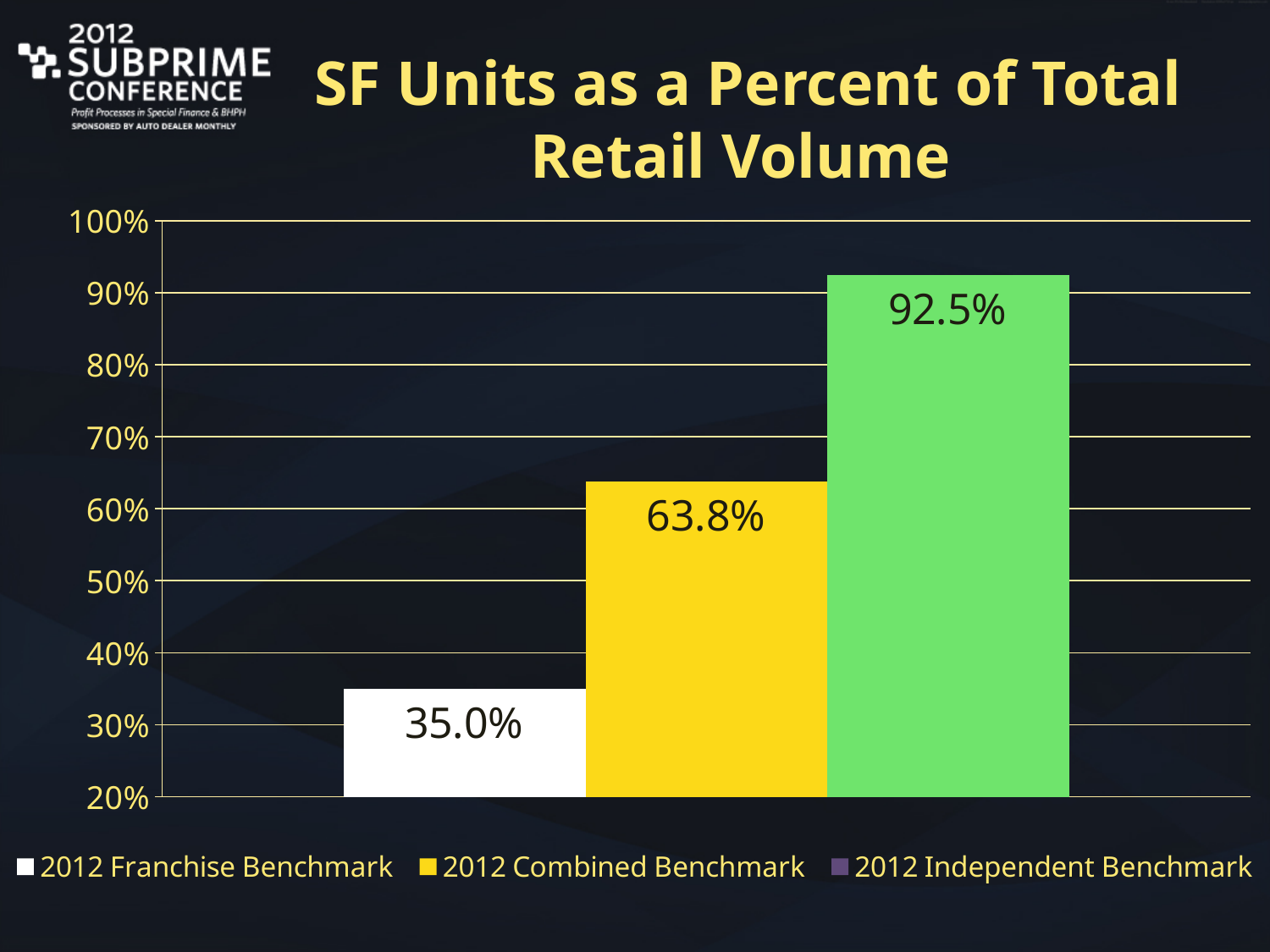
What kind of chart is shown on the slide? Bar chart What is the value for the 2012 Combined Benchmark? 63.8% How many bars are plotted on the chart? 3 What is the difference between the 2012 Combined Benchmark and the 2012 Franchise Benchmark? 28.8% Is the value for the 2012 Combined Benchmark greater or less than 60%? greater How many series does the legend list? 3 What is the value for the 2012 Franchise Benchmark? 35.0% What is the difference between the 2012 Independent Benchmark and the 2012 Franchise Benchmark? 57.5% What is the value for the 2012 Independent Benchmark? 92.5% Which benchmark has the highest SF units as a percent of total retail volume? 2012 Independent Benchmark Which is larger, the 2012 Combined Benchmark or the 2012 Franchise Benchmark? 2012 Combined Benchmark Which benchmark has the lowest SF units as a percent of total retail volume? 2012 Franchise Benchmark